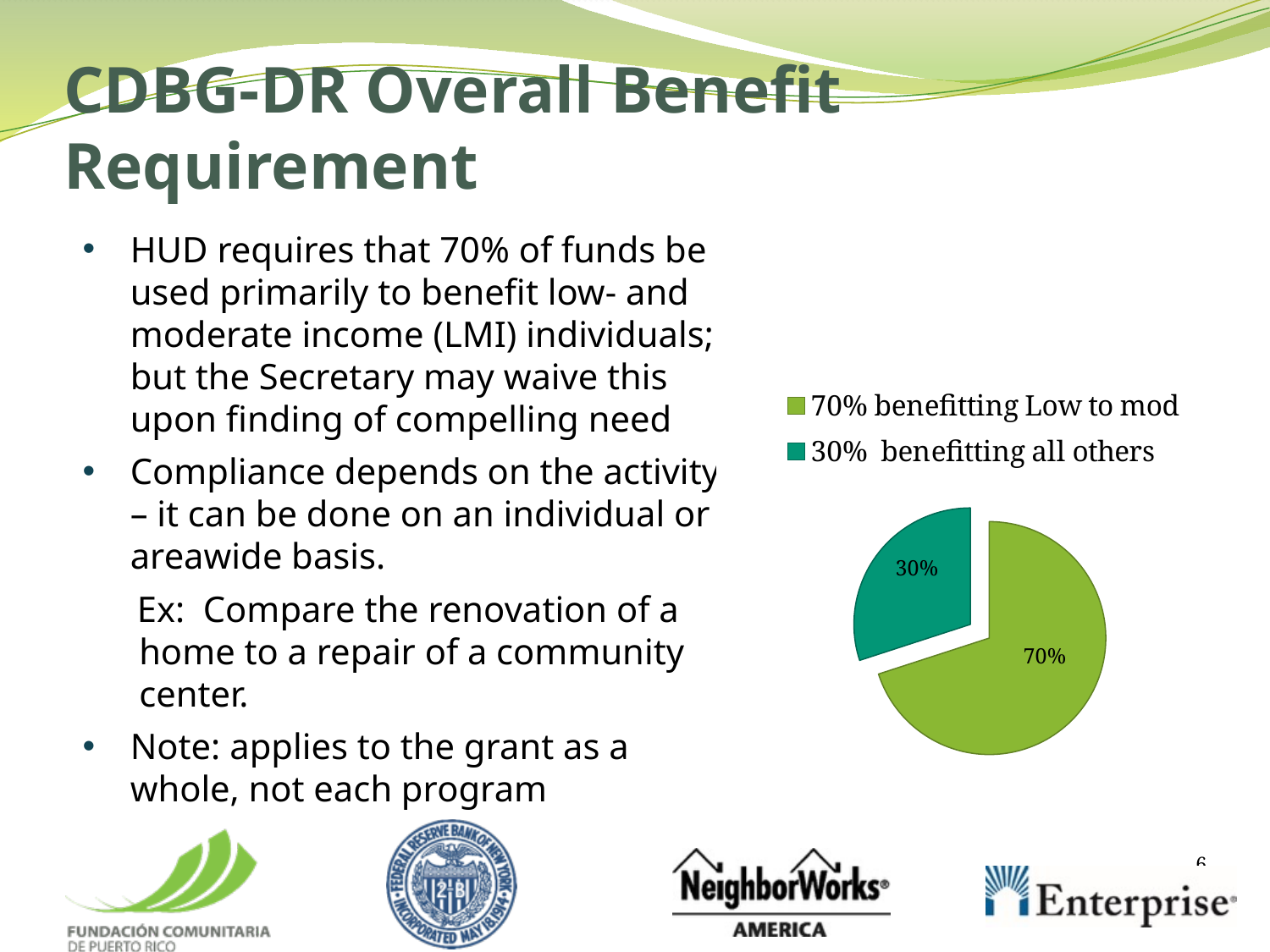
Which slice of the pie is the largest? 70% benefitting Low to mod What share of the pie is labelled for the slice '30% benefitting all others'? 30% What share of the pie is labelled for the slice '70% benefitting Low to mod'? 70% Which is larger: the slice benefitting Low to mod or the slice benefitting all others? 70% benefitting Low to mod What is the difference in percentage points between the two slices of the pie? 40 What colour is the slice labelled 70%? light green Which slice of the pie is the smallest? 30% benefitting all others How many entries does the legend list? 2 How many slices does the pie chart have? 2 Is the share for the slice benefitting all others greater or less than 50%? less What kind of chart is shown on the slide? pie chart